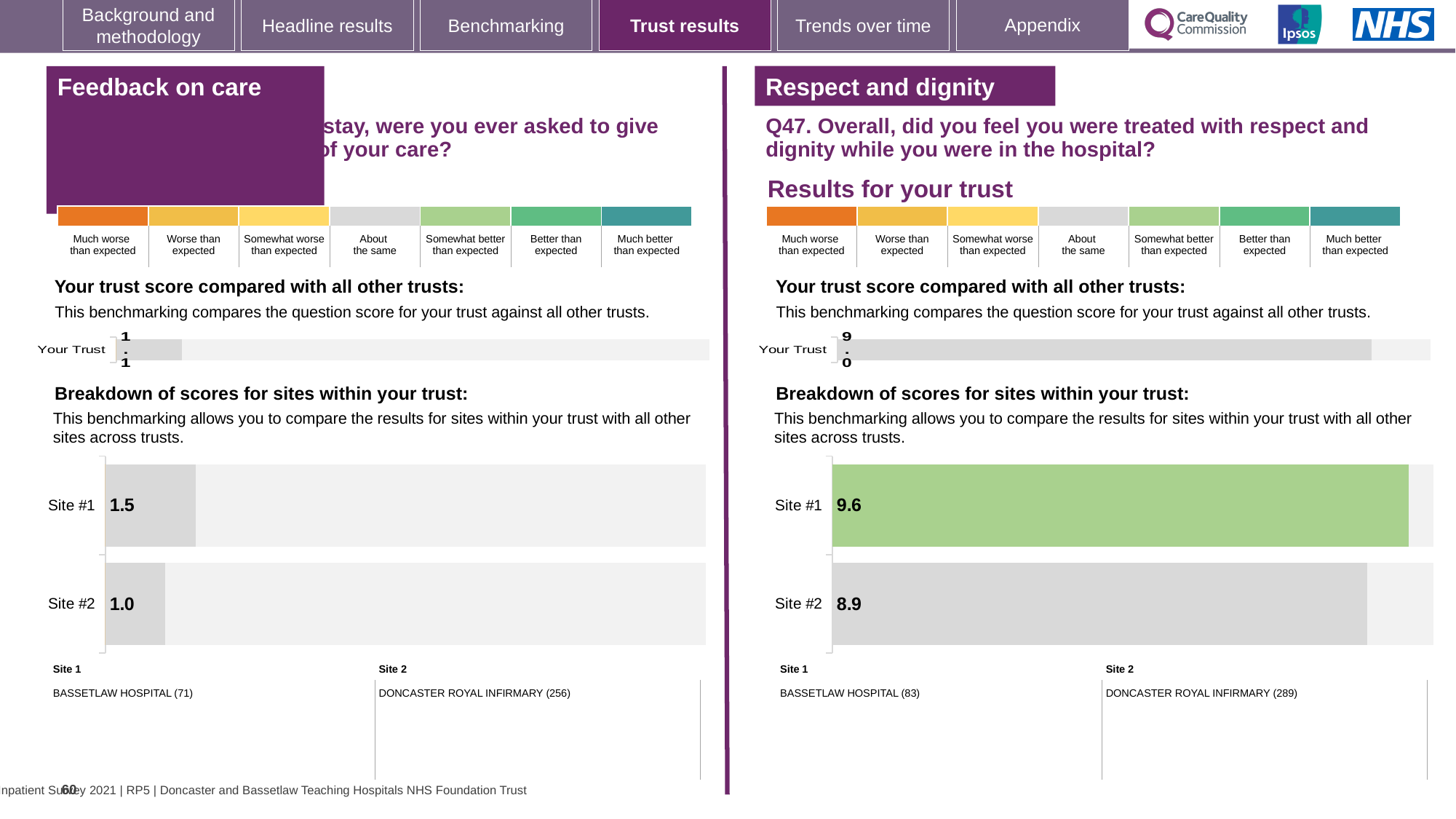
In the 'Feedback on care' site breakdown chart, what is the score for Site #1? 1.5 In the 'Respect and dignity' site breakdown chart, what is the score for Site #2? 8.9 In the 'Respect and dignity' 'Your Trust' chart, what is the trust score shown? 9.0 In the 'Feedback on care' site breakdown chart, what is the score for Site #2? 1.0 In the 'Respect and dignity' site breakdown chart, which site has the higher score? Site #1 In the 'Respect and dignity' site breakdown chart, what is the score for Site #1? 9.6 In the 'Feedback on care' 'Your Trust' chart, what is the trust score shown? 1.1 In the 'Respect and dignity' site breakdown chart, what is the difference between the Site #1 and Site #2 scores? 0.7 How many sites are shown in the 'Respect and dignity' site breakdown chart? 2 In the 'Feedback on care' site breakdown chart, which site has the lower score? Site #2 In the 'Feedback on care' site breakdown chart, what is the difference between the Site #1 and Site #2 scores? 0.5 What type of chart is used for the site breakdown under 'Feedback on care'? Bar chart